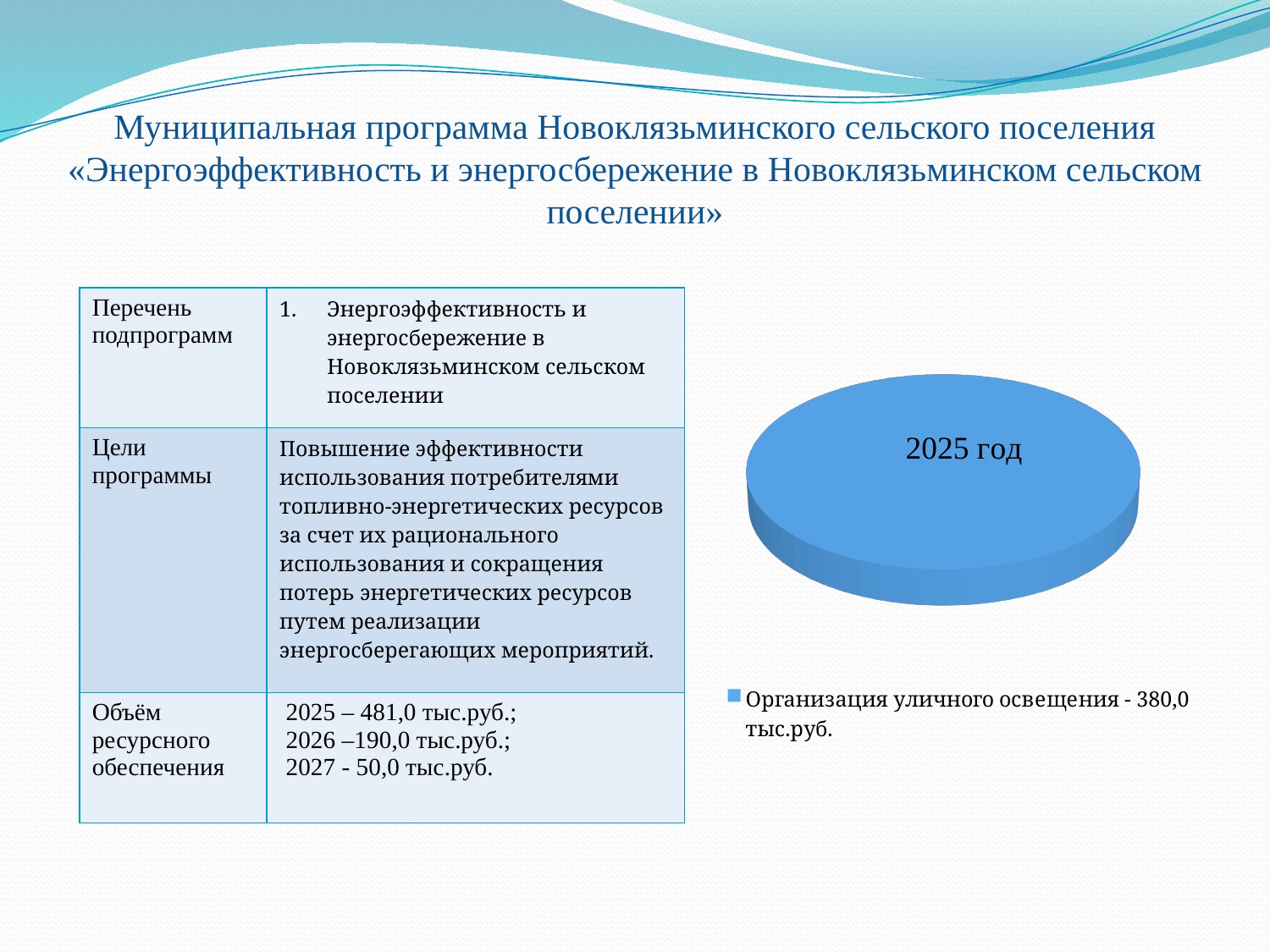
How many slices does the pie chart have? 1 What kind of chart is shown on the slide? pie chart How many entries does the legend of the pie chart list? 1 What share of the pie does the "Организация уличного освещения" slice take up? 100% What is the value shown in the legend for "Организация уличного освещения"? 380,0 тыс.руб. What category does the legend of the pie chart name? Организация уличного освещения - 380,0 тыс.руб. What is the title of the pie chart? 2025 год